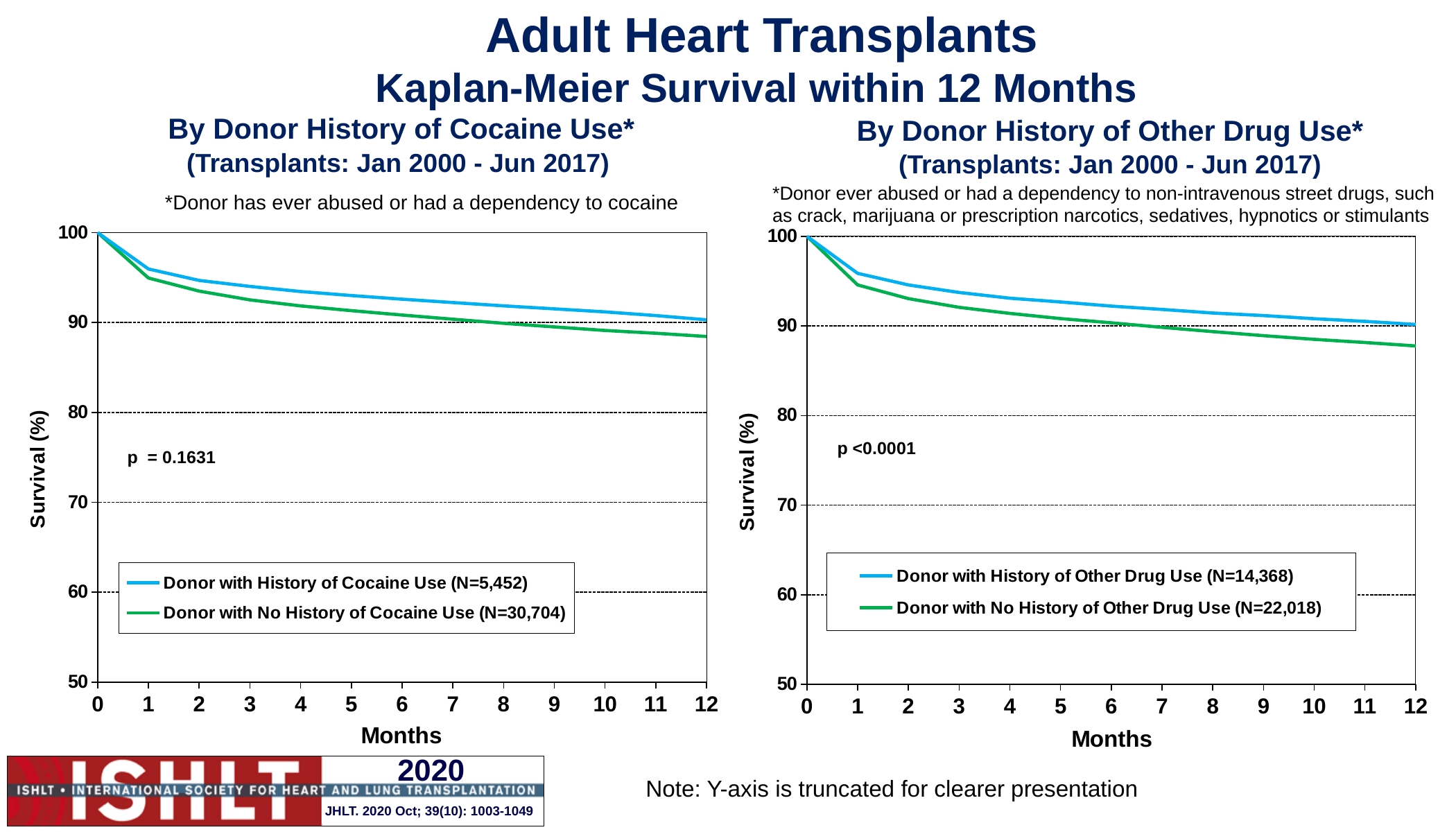
What p-value is shown on the 'By Donor History of Other Drug Use' chart on the right? p <0.0001 In the 'By Donor History of Cocaine Use' chart on the left, is the survival for 'Donor with No History of Cocaine Use' at 12 months greater or less than 90? less What kind of chart is the 'By Donor History of Cocaine Use' chart on the left? line chart How many series does the legend list in the 'By Donor History of Other Drug Use' chart on the right? 2 In the 'By Donor History of Cocaine Use' chart on the left, is the survival for 'Donor with History of Cocaine Use' at month 1 greater or less than 90? greater In the 'By Donor History of Cocaine Use' chart on the left, which series has higher survival at 12 months? Donor with History of Cocaine Use (N=5,452) In the 'By Donor History of Other Drug Use' chart on the right, is the survival for 'Donor with No History of Other Drug Use' at 12 months greater or less than 90? less In the 'By Donor History of Other Drug Use' chart on the right, which series has lower survival at 12 months? Donor with No History of Other Drug Use (N=22,018) In the 'By Donor History of Cocaine Use' chart on the left, what is the N for 'Donor with History of Cocaine Use' shown in the legend? N=5,452 In the 'By Donor History of Other Drug Use' chart on the right, what is the survival value for both series at month 0? 100 How many month tick marks are labelled on the x axis of the 'By Donor History of Cocaine Use' chart on the left? 13 In the 'By Donor History of Cocaine Use' chart on the left, do the survival curves rise or fall as months increase? fall